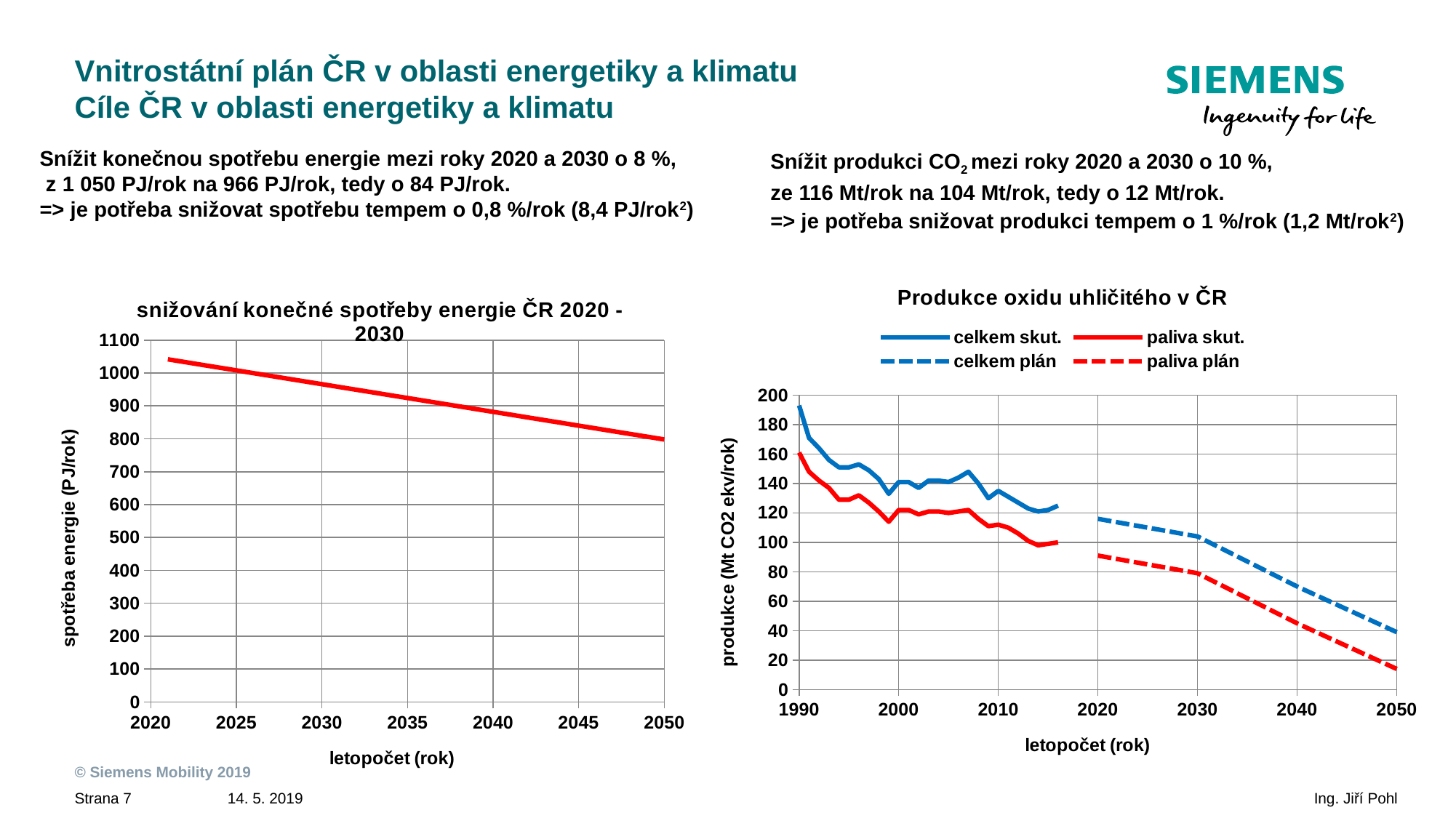
How many series does the legend of the right chart 'Produkce oxidu uhličitého v ČR' list? 4 In the right chart 'Produkce oxidu uhličitého v ČR', is the value of 'celkem skut.' in 1990 greater or less than 180? greater What type of chart is the left chart titled 'snižování konečné spotřeby energie ČR 2020 - 2030'? line chart In the left chart 'snižování konečné spotřeby energie ČR 2020 - 2030', is the value for 2040 greater or less than 900? less In the left chart 'snižování konečné spotřeby energie ČR 2020 - 2030', is the value for 2030 greater or less than 1000? less In the right chart 'Produkce oxidu uhličitého v ČR', which series is higher in 2010, 'celkem skut.' or 'paliva skut.'? celkem skut. In the right chart 'Produkce oxidu uhličitého v ČR', what colour are the 'paliva skut.' and 'paliva plán' lines? red In the right chart 'Produkce oxidu uhličitého v ČR', does the 'celkem plán' series rise or fall from 2020 to 2050? fall In the left chart 'snižování konečné spotřeby energie ČR 2020 - 2030', does the plotted value rise or fall from 2020 to 2050? fall In the left chart 'snižování konečné spotřeby energie ČR 2020 - 2030', what is the y-axis label? spotřeba energie (PJ/rok)